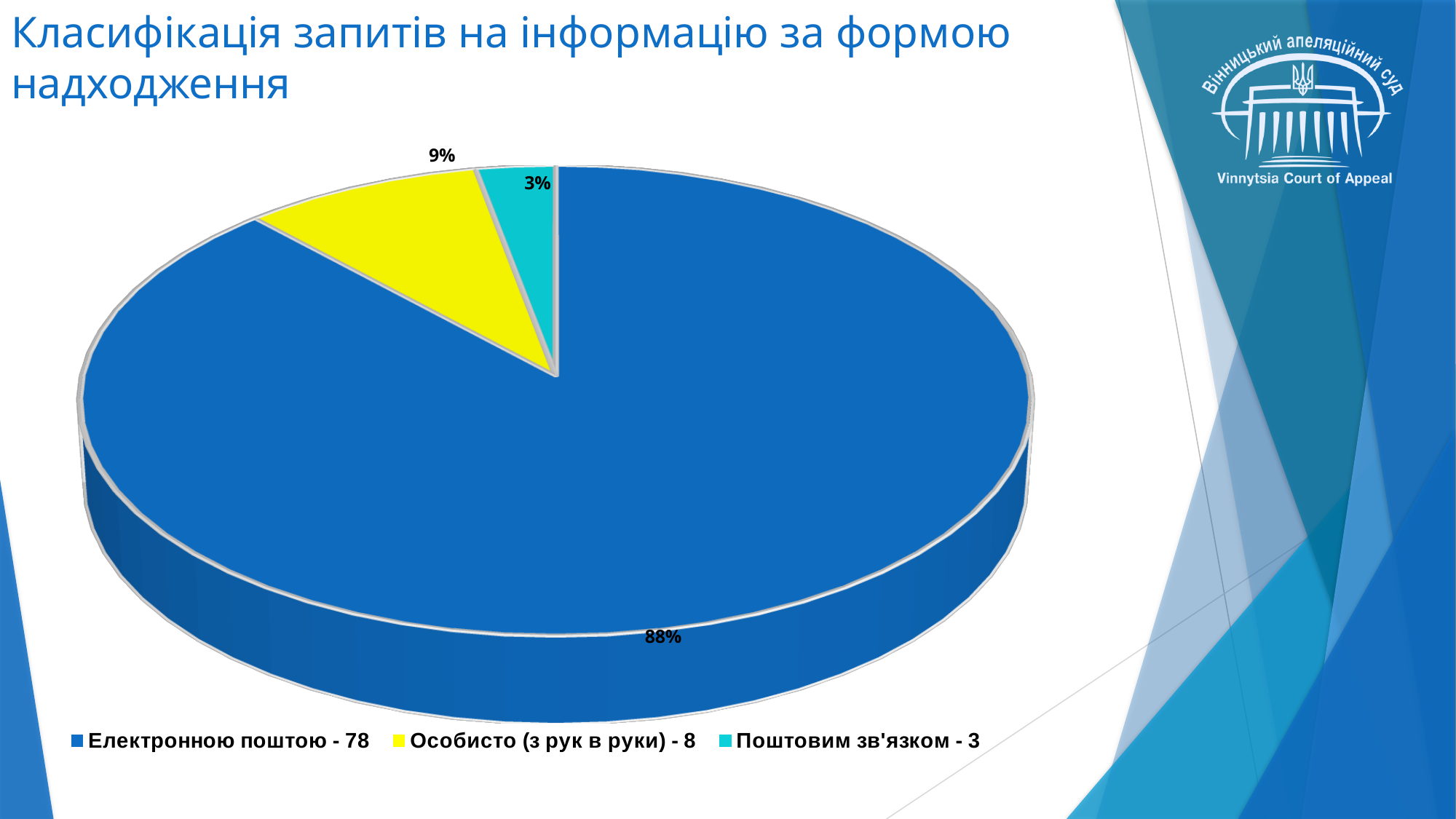
How many slices does the pie chart have? 3 What colour is the slice for "Особисто (з рук в руки) - 8"? Yellow Which category has the largest slice of the pie? Електронною поштою - 78 What is the difference in percentage points between the "Особисто (з рук в руки)" slice and the "Поштовим зв'язком" slice? 6 What percentage share does the slice for "Поштовим зв'язком - 3" have? 3% What is the difference in percentage points between the "Електронною поштою" slice and the "Особисто (з рук в руки)" slice? 79 What percentage share does the slice for "Електронною поштою - 78" have? 88% Which category has the smallest slice of the pie? Поштовим зв'язком - 3 Which slice is larger: "Особисто (з рук в руки)" or "Поштовим зв'язком"? Особисто (з рук в руки) What kind of chart is shown on the slide? Pie chart What is the title of the chart on the slide? Класифікація запитів на інформацію за формою надходження What percentage share does the slice for "Особисто (з рук в руки) - 8" have? 9%